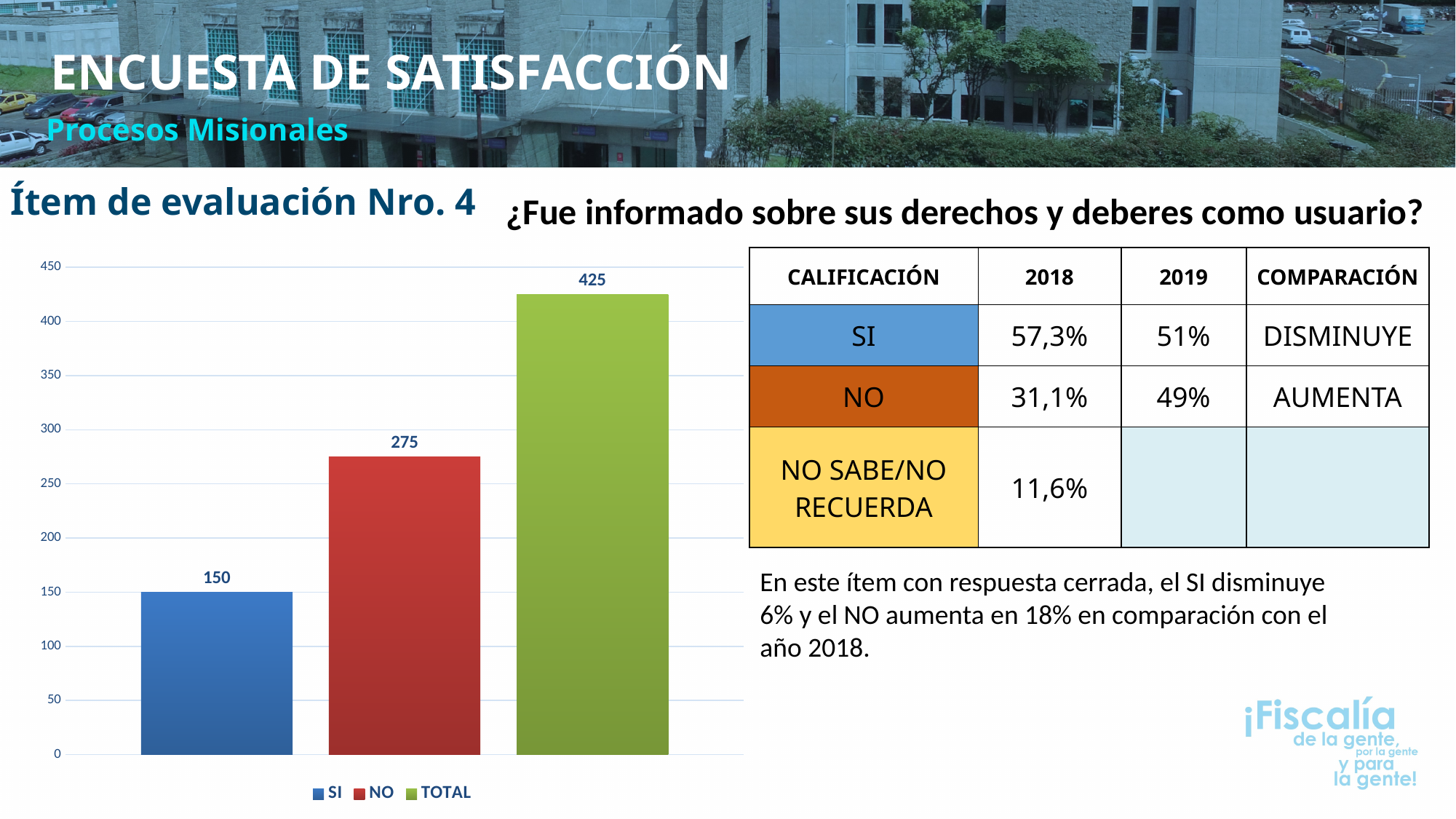
What is the value of the TOTAL bar in the chart? 425 What is the difference between the NO bar and the SI bar in the chart? 125 What type of chart is shown on the slide? bar chart Which bar in the chart has the highest value? TOTAL Is the value of the NO bar greater or less than 300? less What is the value of the SI bar in the chart? 150 How many entries does the chart legend list? 3 Which is larger in the chart, the SI bar or the NO bar? NO What is the difference between the TOTAL bar and the NO bar in the chart? 150 How many bars are plotted in the chart? 3 What is the value of the NO bar in the chart? 275 Which bar in the chart has the lowest value? SI